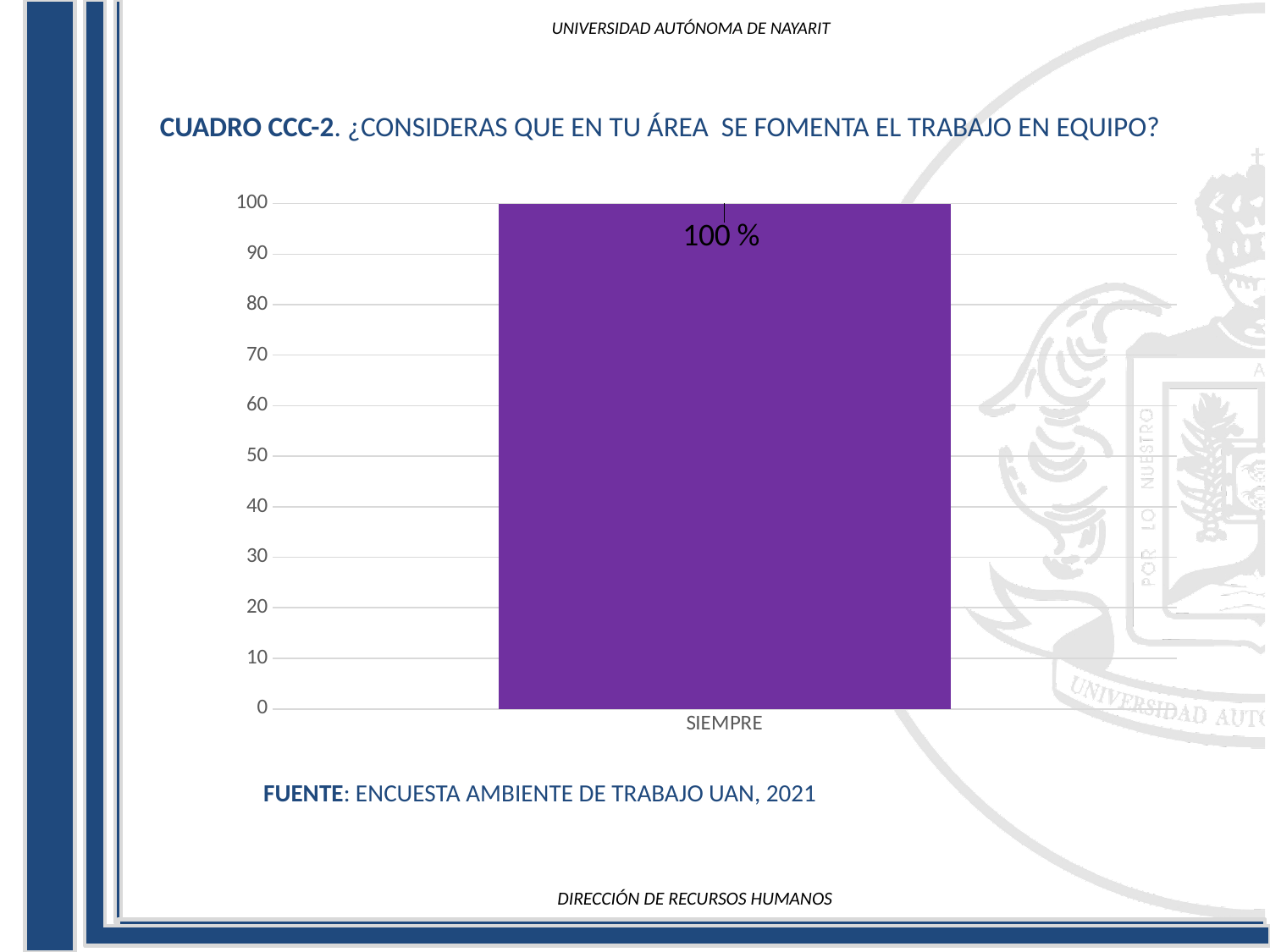
What kind of chart is shown on the slide? bar chart What is the label of the only category on the x axis? SIEMPRE What is the value for SIEMPRE? 100 % Is the value for SIEMPRE greater or less than 50? greater How many categories are plotted in the chart? 1 Is the value for SIEMPRE greater or less than 90? greater What is the maximum value shown on the y axis? 100 Which category has the highest value in the chart? SIEMPRE